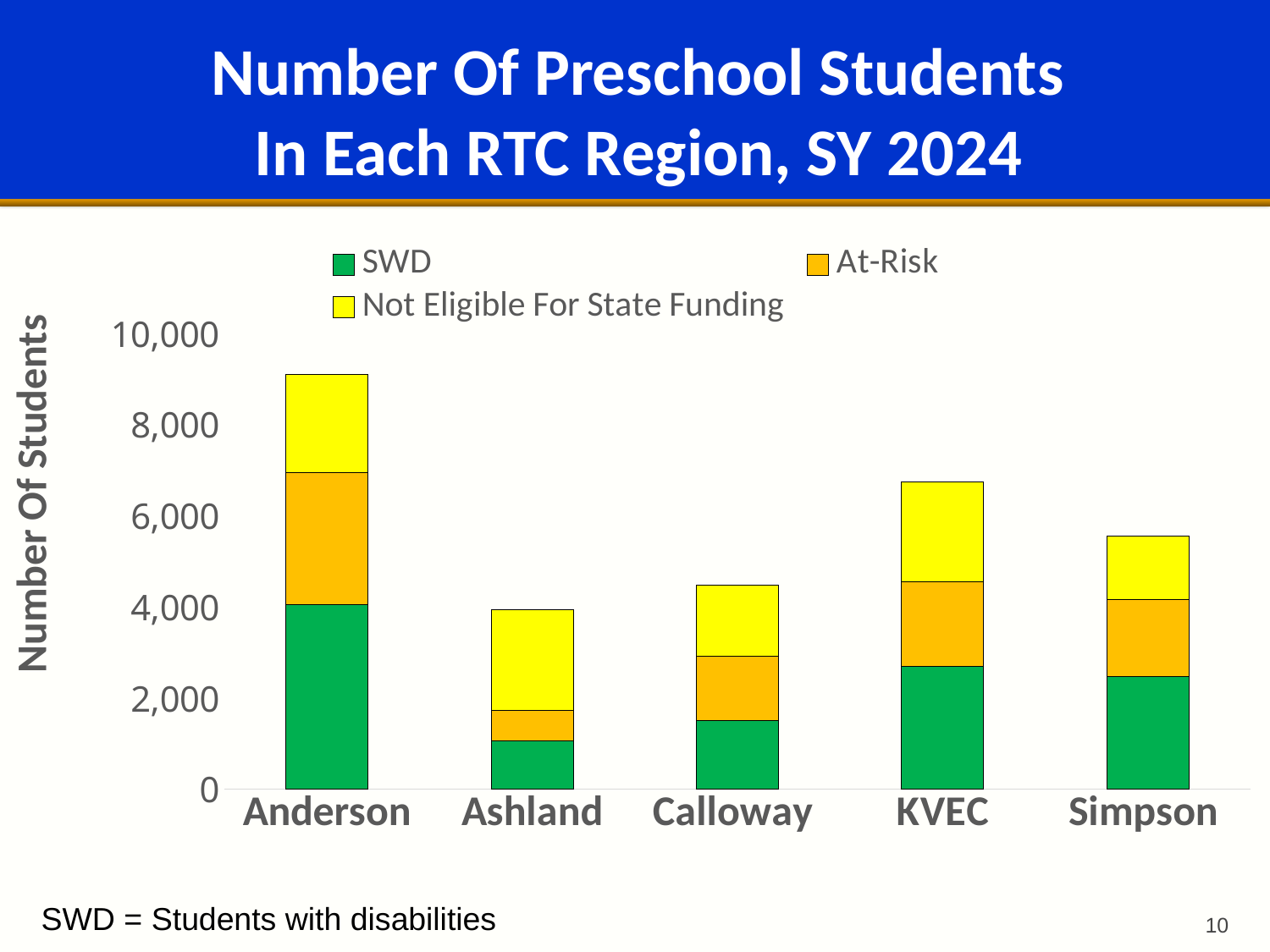
Which colour represents the SWD series in the legend? Green Which region has more preschool students in total, KVEC or Simpson? KVEC What kind of chart is shown on the slide? Stacked bar chart What is the title of the y axis? Number Of Students Is the total number of preschool students for KVEC greater or less than 6,000? greater How many RTC regions are shown on the x axis? 5 Which region has the shortest stacked bar (the fewest preschool students)? Ashland Is the SWD value for Anderson greater or less than 2,000? greater Is the total number of preschool students for Ashland greater or less than 6,000? less How many series does the legend list? 3 Which region has the tallest stacked bar (the most preschool students)? Anderson